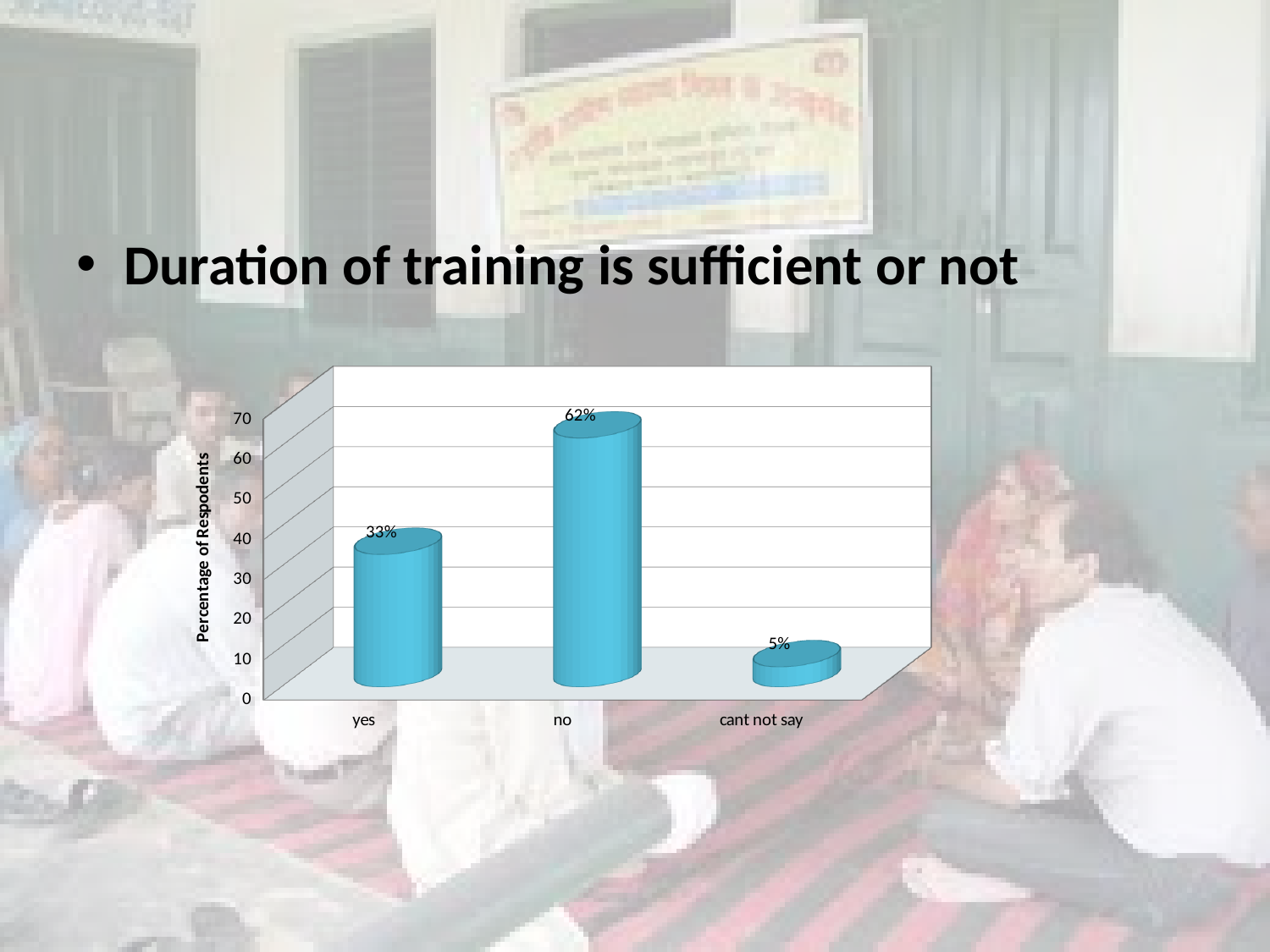
What is the difference in percentage points between the "yes" and "cant not say" responses? 28 What percentage of respondents answered "cant not say"? 5% What kind of chart is shown on the slide? bar chart Is the value for "yes" greater or less than 40? less What is the difference in percentage points between the "no" and "yes" responses? 29 What is the label of the vertical axis? Percentage of Respodents What percentage of respondents answered "yes"? 33% How many response categories are shown on the x axis? 3 Which response category has the highest percentage of respondents? no Which is larger, the percentage for "yes" or for "no"? no What percentage of respondents answered "no"? 62% Which response category has the lowest percentage of respondents? cant not say